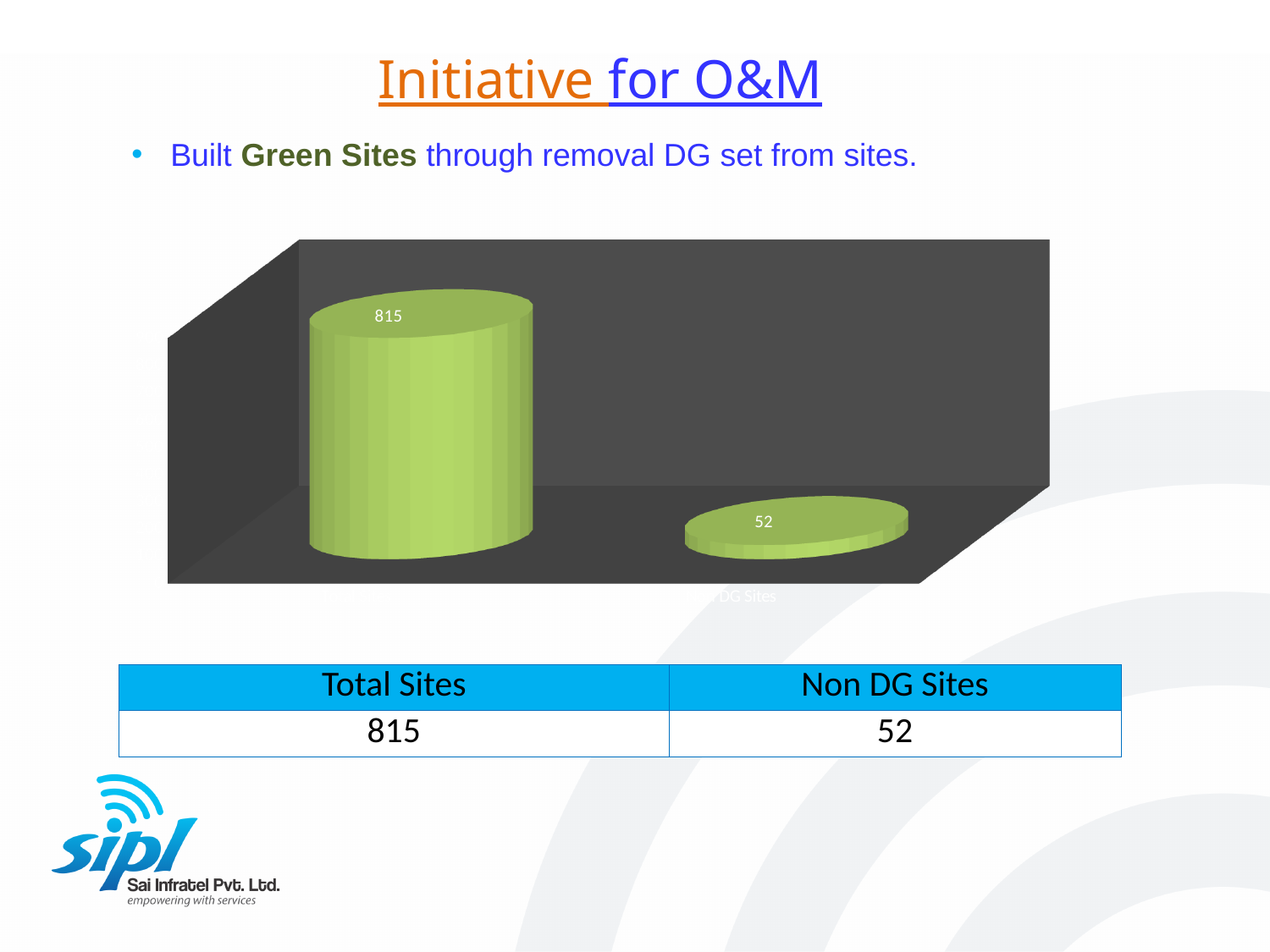
Which bar in the chart is the highest, the left one or the right one? the left one What kind of chart is shown on the slide? bar chart According to the slide, what is the value for Non DG Sites? 52 What value is shown on the short right bar of the chart? 52 What is the title of the slide containing the chart? Initiative for O&M What is the difference between the two values plotted in the chart, 815 and 52? 763 How many bars are plotted in the chart? 2 Which bar in the chart is the lowest, the left one or the right one? the right one What value is shown on the tall left bar of the chart? 815 What colour are the bars in the chart? green According to the slide, what is the value for Total Sites? 815 Is the value for Total Sites larger or smaller than the value for Non DG Sites? larger